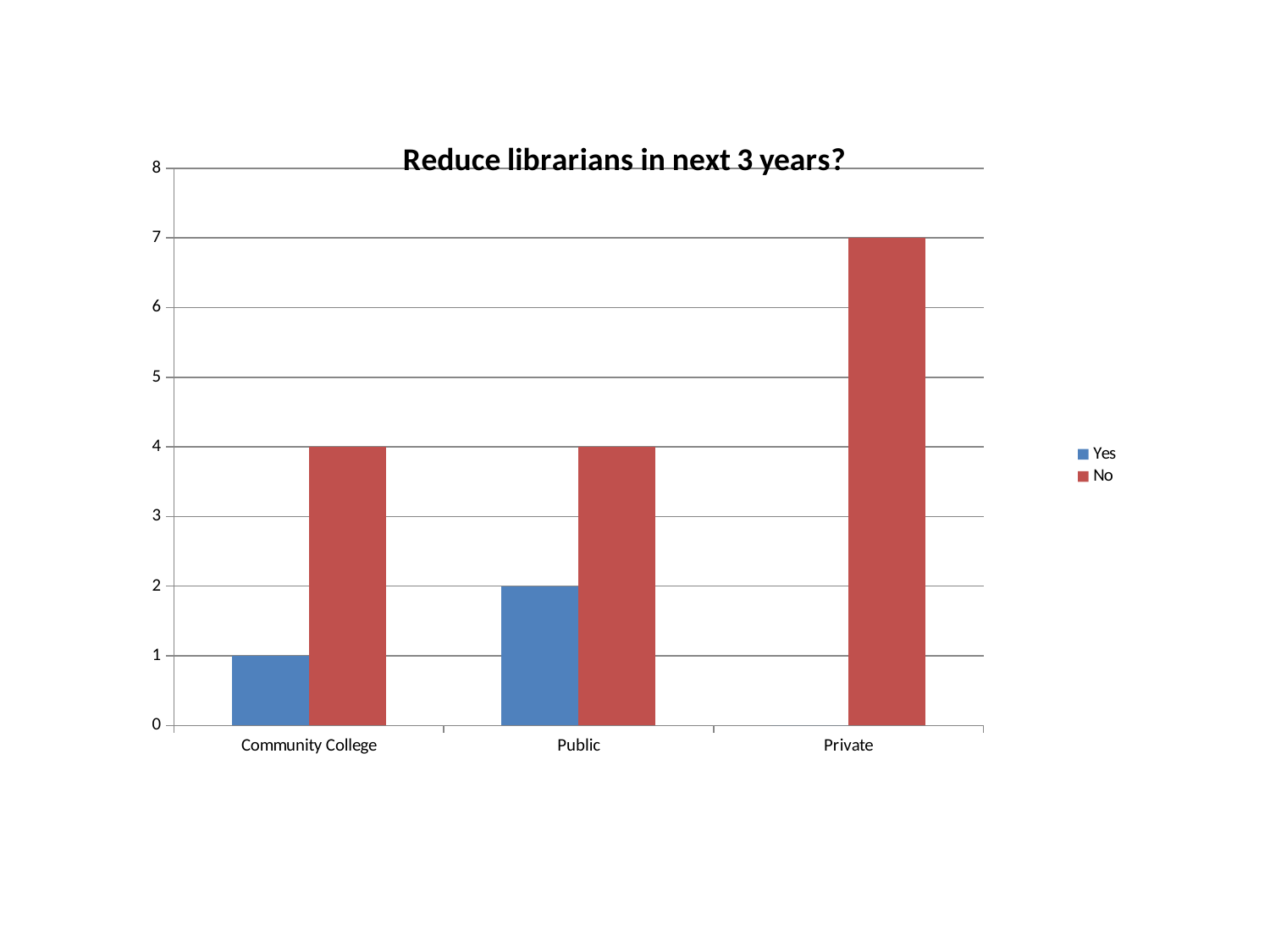
What is the value of the No bar for Community College? 4 What is the title of the chart? Reduce librarians in next 3 years? What is the value of the Yes bar for Public? 2 Which category has the lowest Yes value? Private What is the value of the No bar for Private? 7 How many categories are shown on the x axis? 3 What kind of chart is shown on the slide? Bar chart What is the difference between the No value for Private and the No value for Public? 3 How many series does the legend list? 2 Which is larger, the Yes value for Public or the Yes value for Community College? Public What is the value of the Yes bar for Community College? 1 Which category has the highest No value? Private